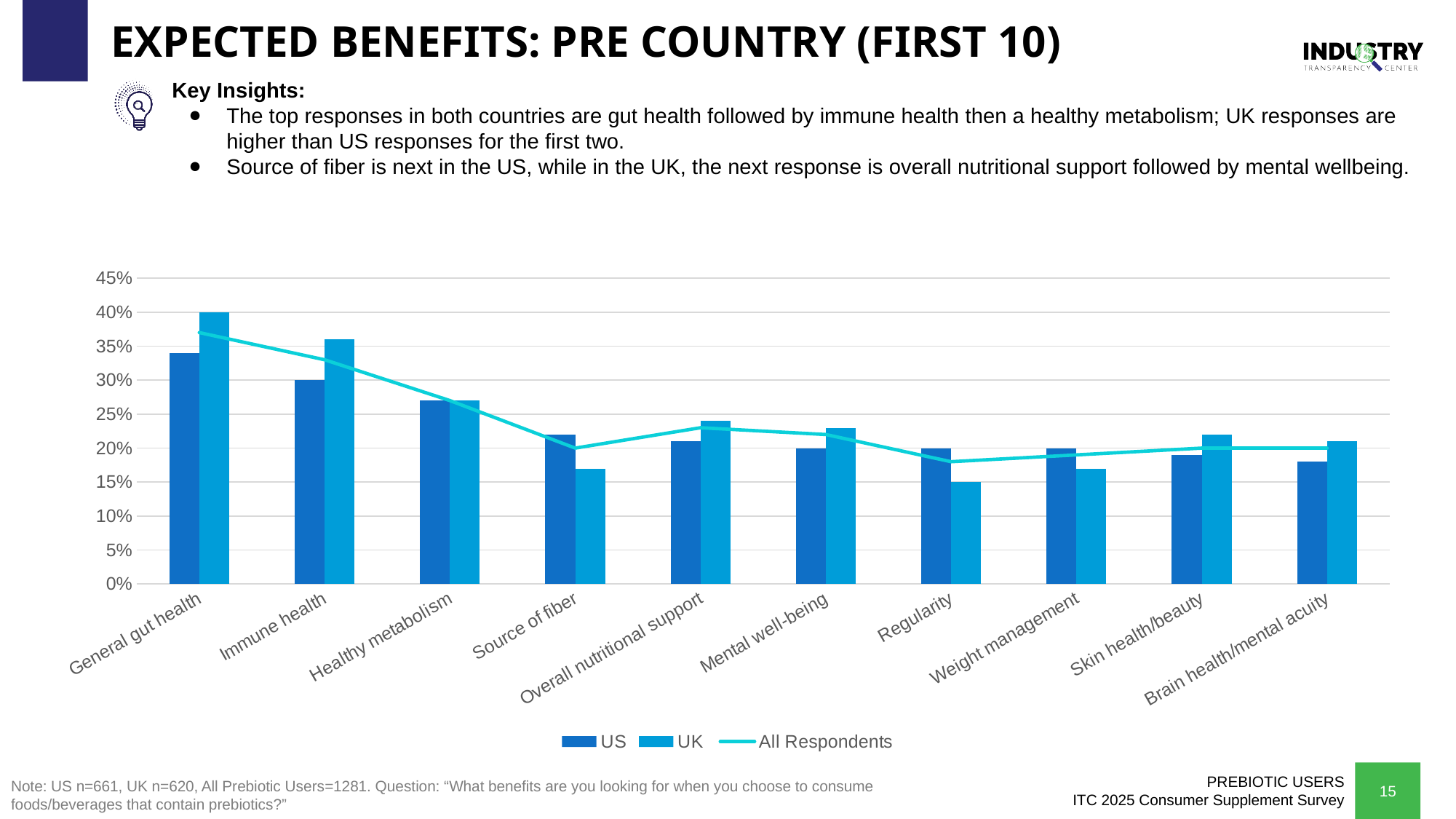
What kind of chart is shown on the slide? bar chart with a line Is the UK value for Source of fiber greater or less than 20%? less For General gut health, which is larger, the US value or the UK value? UK What is the UK value for General gut health? 40% Which category has the lowest UK value? Regularity Is the US value for General gut health greater or less than 30%? greater How many benefit categories are shown on the x axis? 10 Which category has the highest UK value? General gut health For Source of fiber, which is larger, the US value or the UK value? US What is the US value for Immune health? 30% What is the UK value for Regularity? 15% How many series does the legend list? 3